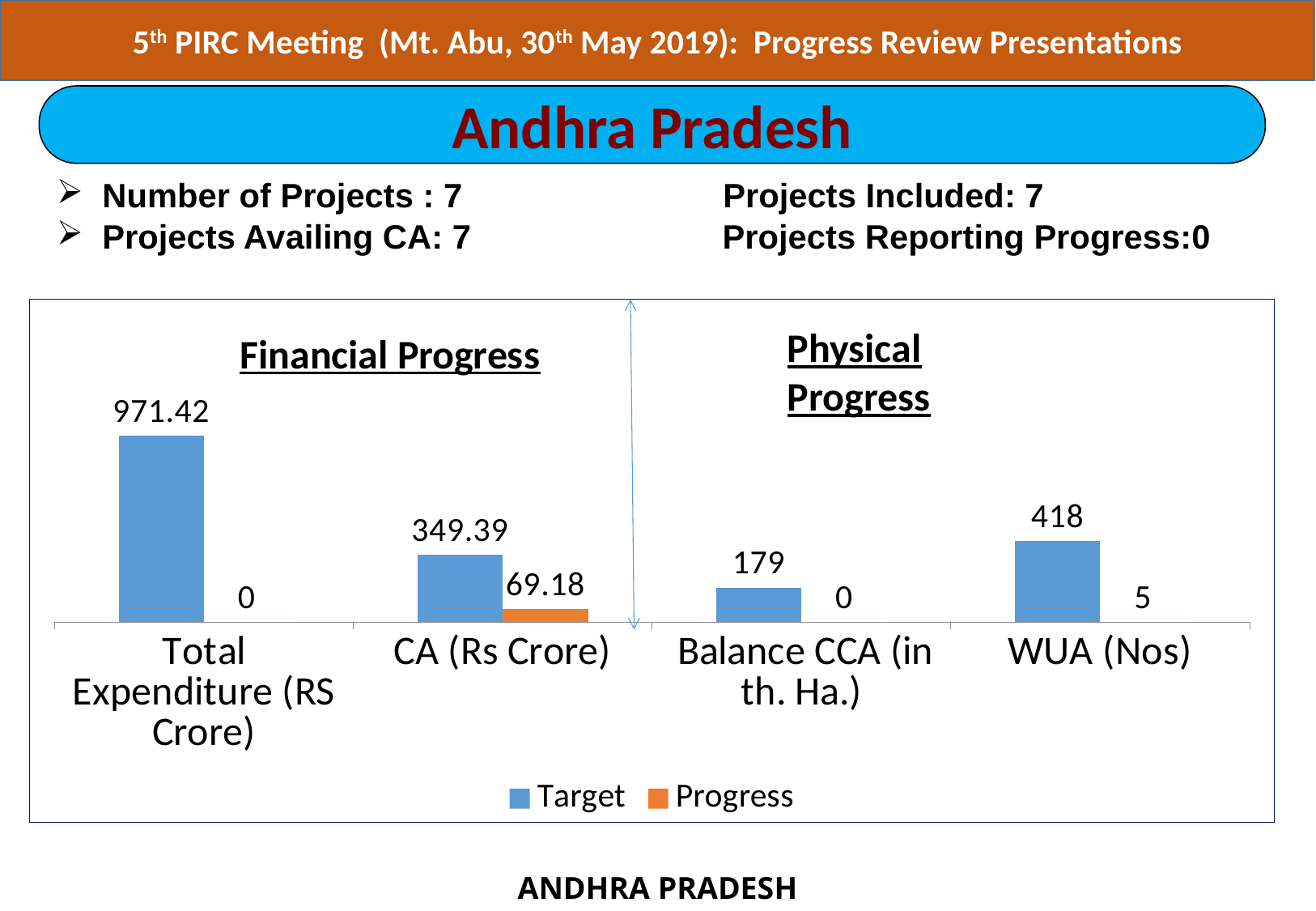
What kind of chart is shown on the slide? Bar chart What is the Progress value for WUA (Nos)? 5 How many series does the legend list? 2 How many categories are shown on the x axis? 4 What is the Progress value for CA (Rs Crore)? 69.18 What is the Target value for Balance CCA (in th. Ha.)? 179 Which is larger, the Target for WUA (Nos) or the Target for CA (Rs Crore)? WUA (Nos) Which category has the lowest Target value? Balance CCA (in th. Ha.) What is the difference between the Target and Progress values for CA (Rs Crore)? 280.21 Which category has the highest Target value? Total Expenditure (RS Crore) What colour are the Progress bars? Orange What is the Target value for Total Expenditure (RS Crore)? 971.42